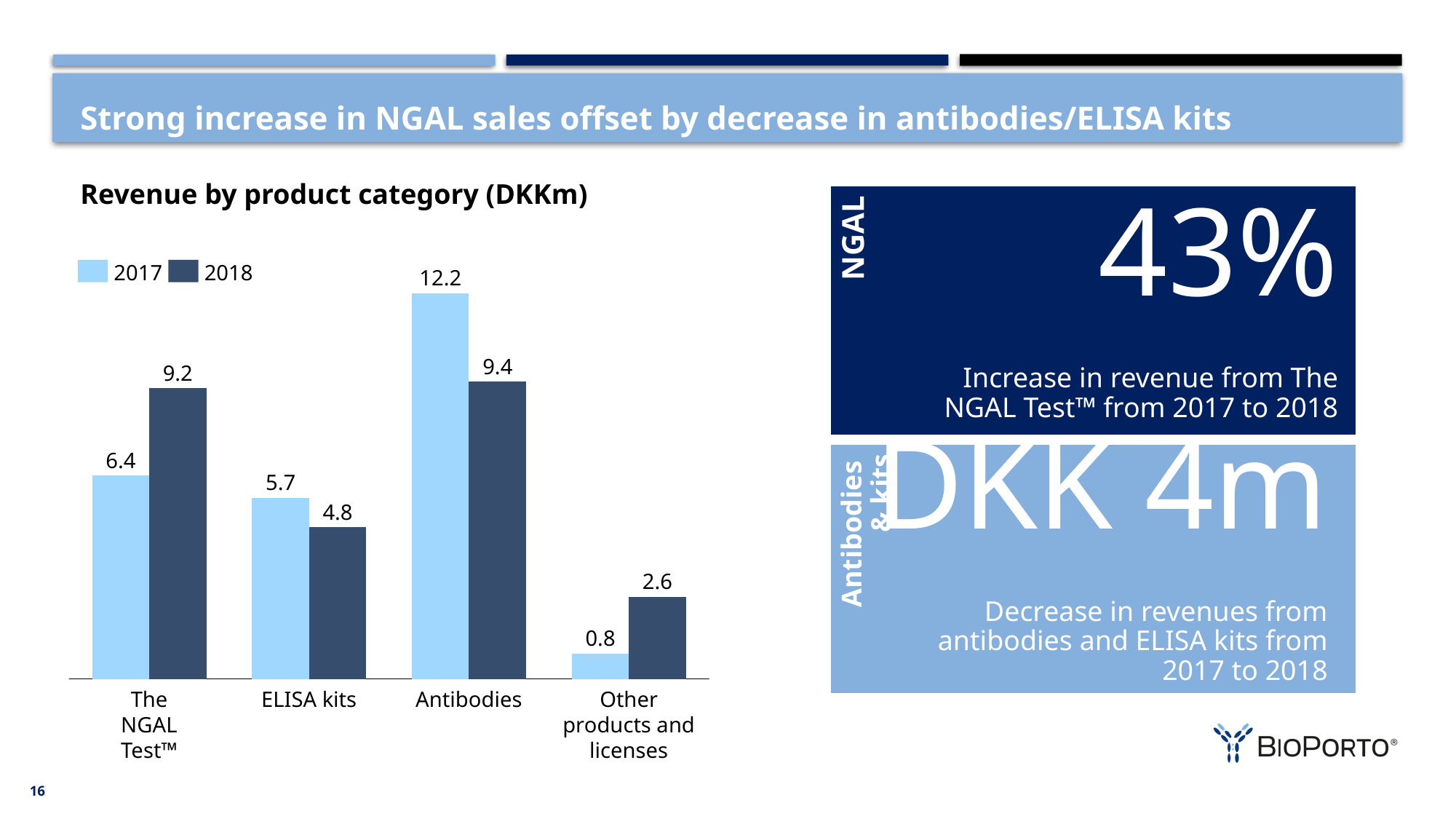
What was the 2017 revenue for Antibodies? 12.2 What is the difference between the 2017 and 2018 revenue for Antibodies? 2.8 Which was larger: ELISA kits revenue in 2017 or in 2018? 2017 Which product category had the lowest revenue in 2018? Other products and licenses How many product categories are shown on the chart? 4 What was the 2018 revenue for The NGAL Test™? 9.2 What was the 2017 revenue for Other products and licenses? 0.8 How many series does the legend list? 2 Which product category had the highest revenue in 2017? Antibodies What is the title of the chart? Revenue by product category (DKKm) What kind of chart is used to show revenue by product category? Bar chart By how much did revenue from The NGAL Test™ increase from 2017 to 2018? 2.8